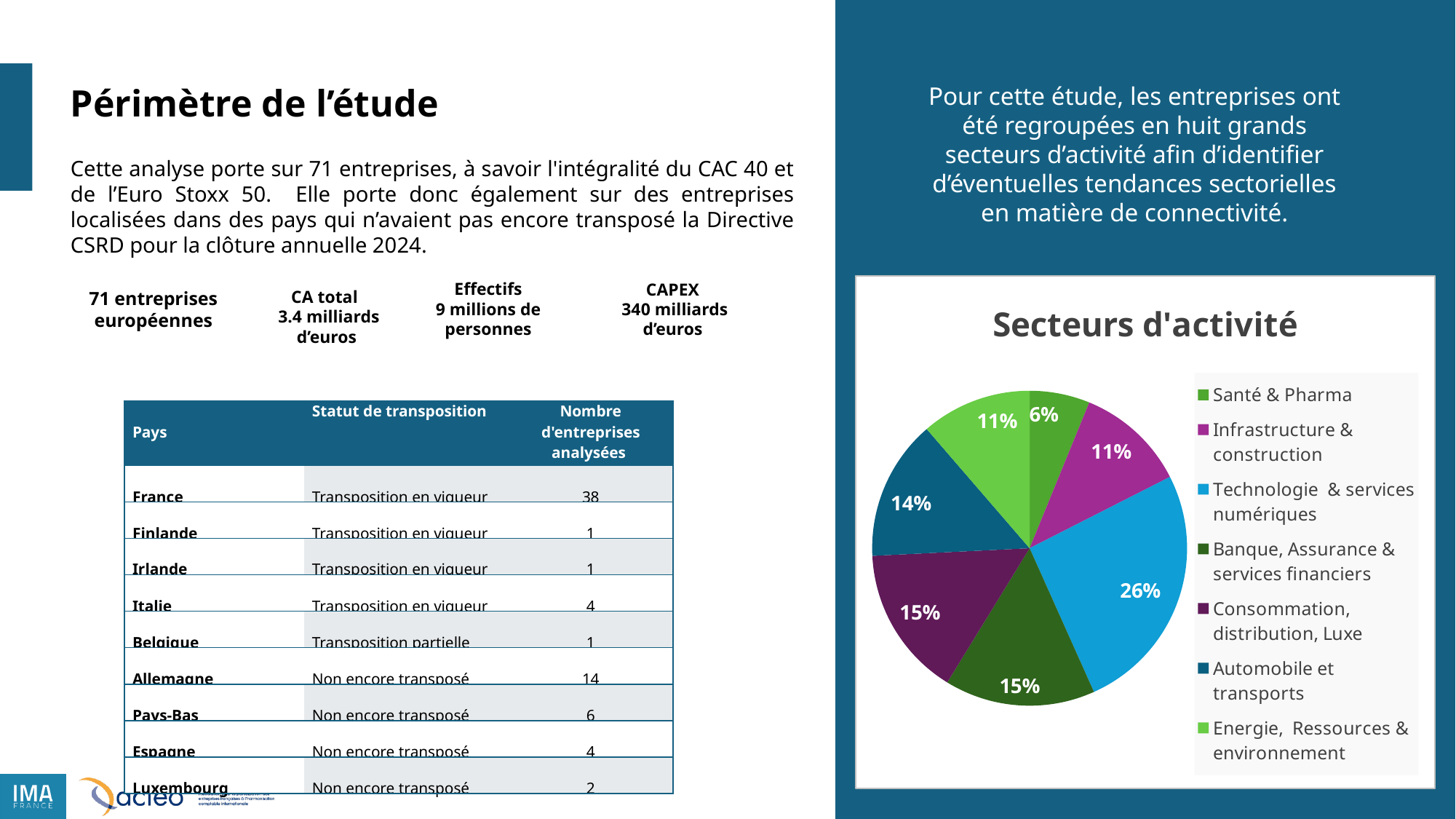
Which sector has the largest slice in the "Secteurs d'activité" pie chart? Technologie & services numériques In the "Secteurs d'activité" pie chart, which is larger: Automobile et transports or Energie, Ressources & environnement? Automobile et transports What is the title of the pie chart on the right side of the slide? Secteurs d'activité Which sector has the smallest slice in the "Secteurs d'activité" pie chart? Santé & Pharma In the "Secteurs d'activité" pie chart, what share does Consommation, distribution, Luxe have? 15% How many entries does the legend of the "Secteurs d'activité" pie chart list? 7 In the "Secteurs d'activité" pie chart, what share does Automobile et transports have? 14% In the "Secteurs d'activité" pie chart, what share does Infrastructure & construction have? 11% In the "Secteurs d'activité" pie chart, what share does Santé & Pharma have? 6% In the "Secteurs d'activité" pie chart, what is the difference in percentage points between Technologie & services numériques and Automobile et transports? 12 In the "Secteurs d'activité" pie chart, what share does Technologie & services numériques have? 26% What kind of chart is shown under the title "Secteurs d'activité"? pie chart